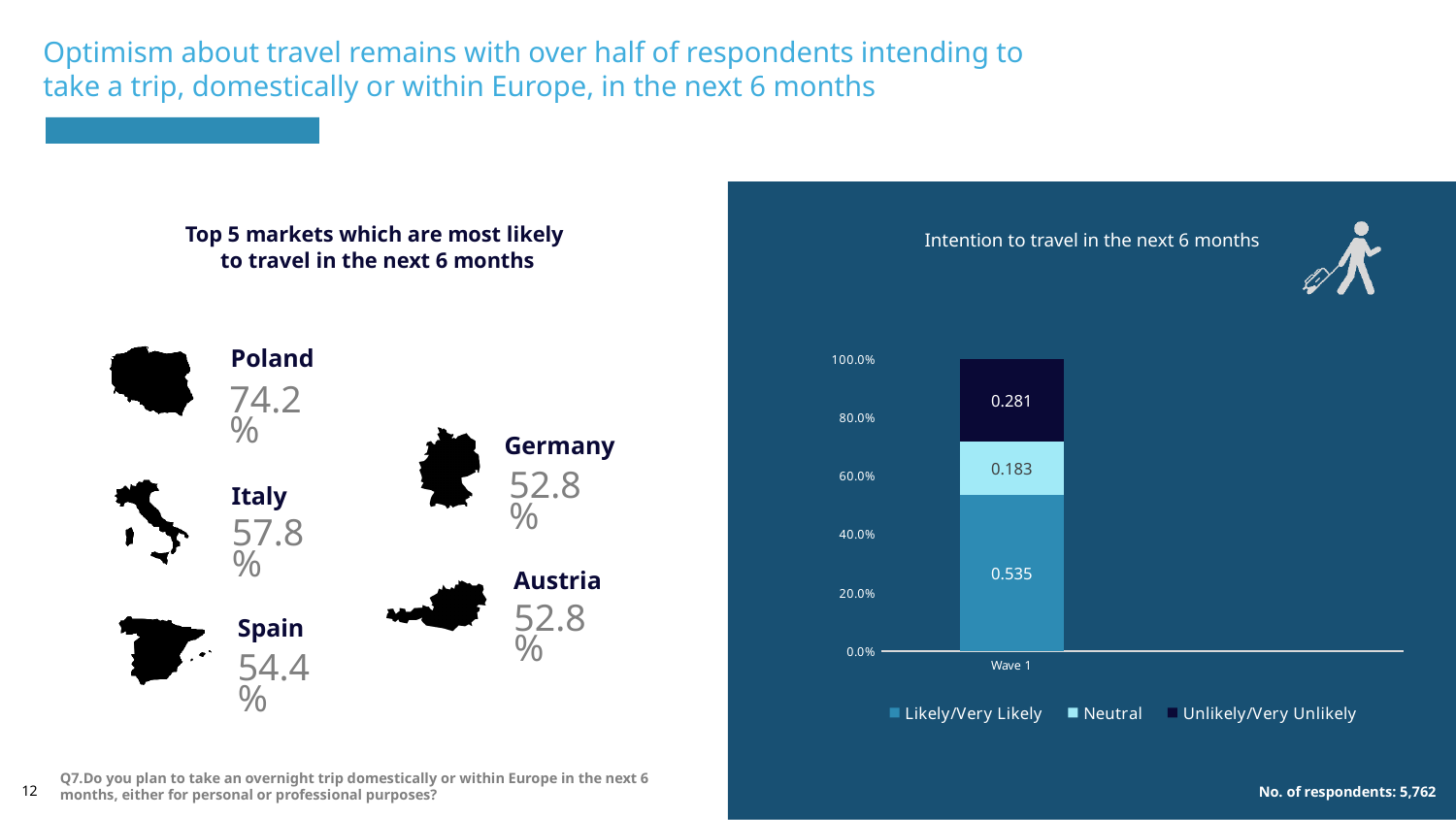
What is the value for Unlikely/Very Unlikely in the Wave 1 bar? 0.281 What kind of chart is shown on the slide? Stacked bar chart Which series has the largest segment in the Wave 1 bar? Likely/Very Likely How many series does the legend list? 3 How many categories are shown on the x axis of the chart? 1 Which is larger in the Wave 1 bar, Neutral or Unlikely/Very Unlikely? Unlikely/Very Unlikely What is the difference between the Likely/Very Likely and Unlikely/Very Unlikely values in the Wave 1 bar? 0.254 What is the value for Likely/Very Likely in the Wave 1 bar? 0.535 What is the title of the chart? Intention to travel in the next 6 months Which series has the smallest segment in the Wave 1 bar? Neutral What is the difference between the Unlikely/Very Unlikely and Neutral values in the Wave 1 bar? 0.098 What is the value for Neutral in the Wave 1 bar? 0.183